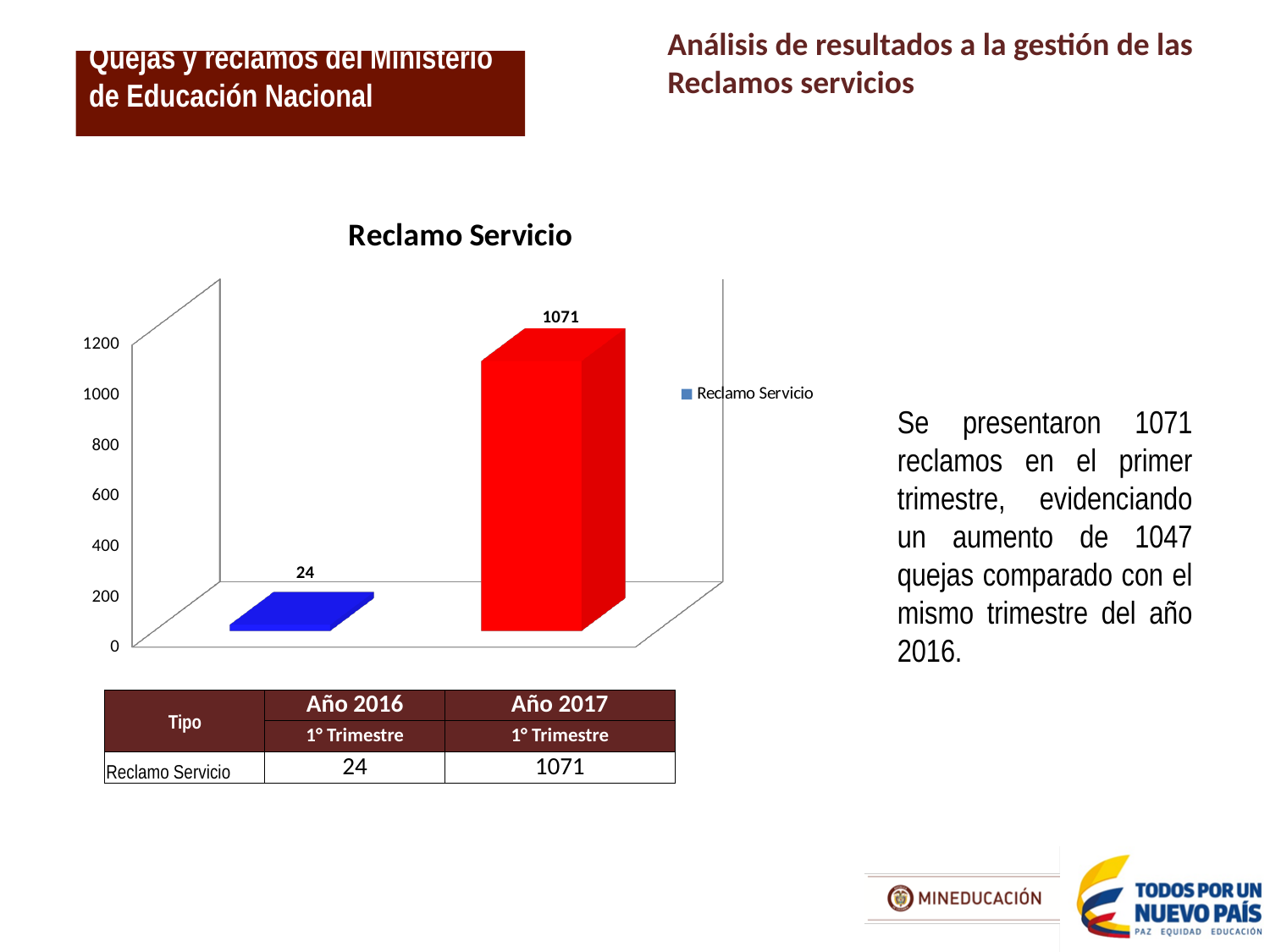
How many bars are plotted in the Reclamo Servicio chart? 2 What is the highest value shown in the Reclamo Servicio chart? 1071 What is the title of the chart? Reclamo Servicio What is the difference between the two bar values in the Reclamo Servicio chart? 1047 What is the lowest value shown in the Reclamo Servicio chart? 24 What value is labelled on the blue bar in the Reclamo Servicio chart? 24 How many series does the legend of the Reclamo Servicio chart list? 1 What is the name of the series shown in the legend of the chart? Reclamo Servicio Is the value of the red bar in the Reclamo Servicio chart greater or less than 1000? greater What value is labelled on the red bar in the Reclamo Servicio chart? 1071 What type of chart is shown on the slide? bar chart Which bar is taller in the Reclamo Servicio chart, the blue one or the red one? the red one